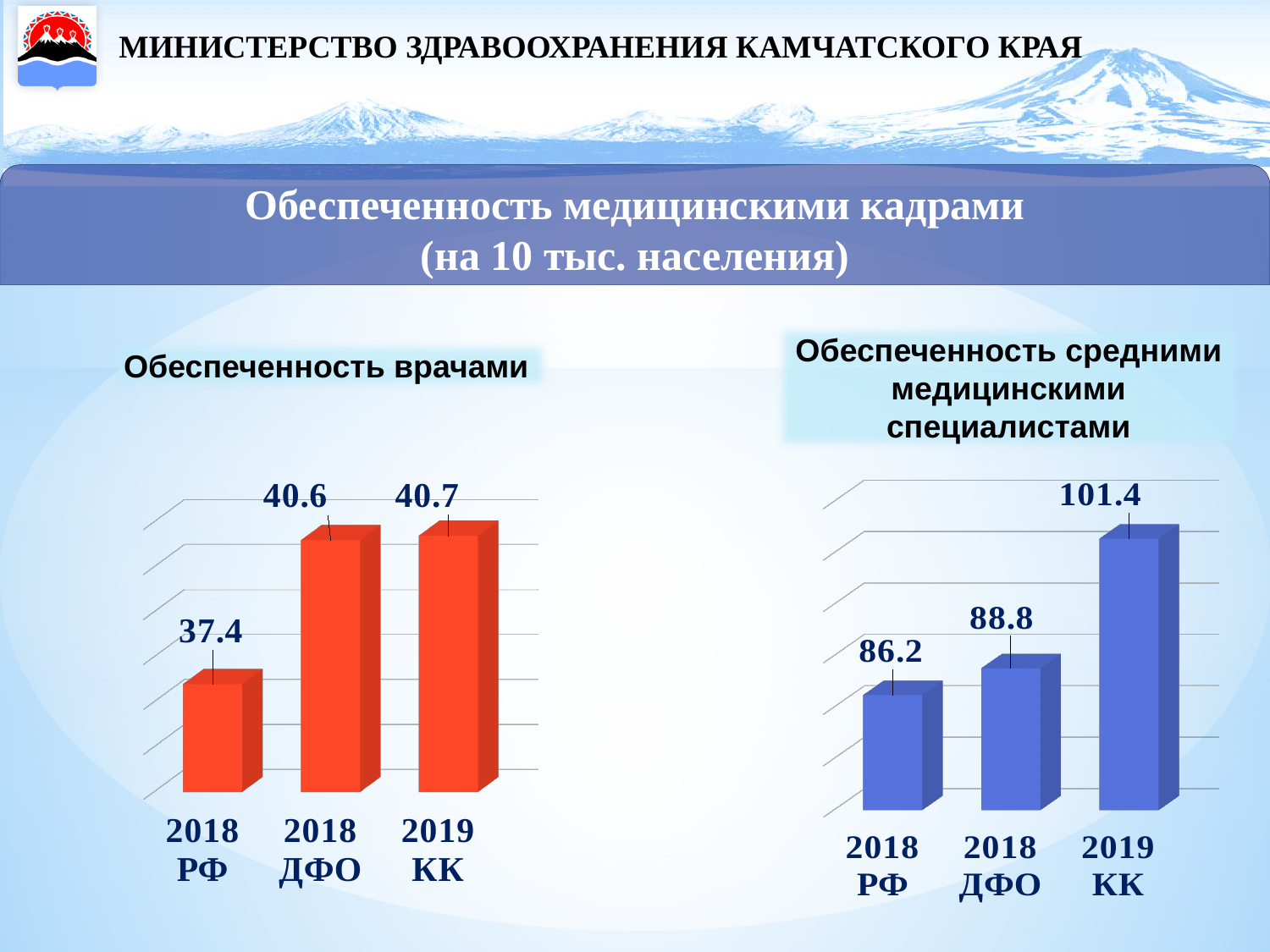
In the right chart (Обеспеченность средними медицинскими специалистами), which category has the highest value? 2019 КК In the left chart (Обеспеченность врачами), which category has the lowest value? 2018 РФ In the left chart (Обеспеченность врачами), what is the value for 2019 КК? 40.7 In the left chart (Обеспеченность врачами), what is the difference between the values for 2018 ДФО and 2018 РФ? 3.2 In the right chart (Обеспеченность средними медицинскими специалистами), what is the difference between the values for 2019 КК and 2018 РФ? 15.2 How many bars are shown in the left chart (Обеспеченность врачами)? 3 What type of chart is the right chart (Обеспеченность средними медицинскими специалистами)? Bar chart In the right chart (Обеспеченность средними медицинскими специалистами), what is the value for 2018 ДФО? 88.8 In the right chart (Обеспеченность средними медицинскими специалистами), what is the value for 2019 КК? 101.4 In the right chart (Обеспеченность средними медицинскими специалистами), which is larger: the value for 2018 РФ or 2018 ДФО? 2018 ДФО In the left chart (Обеспеченность врачами), what is the value for 2018 РФ? 37.4 Do the values in the right chart (Обеспеченность средними медицинскими специалистами) rise or fall from left to right? Rise